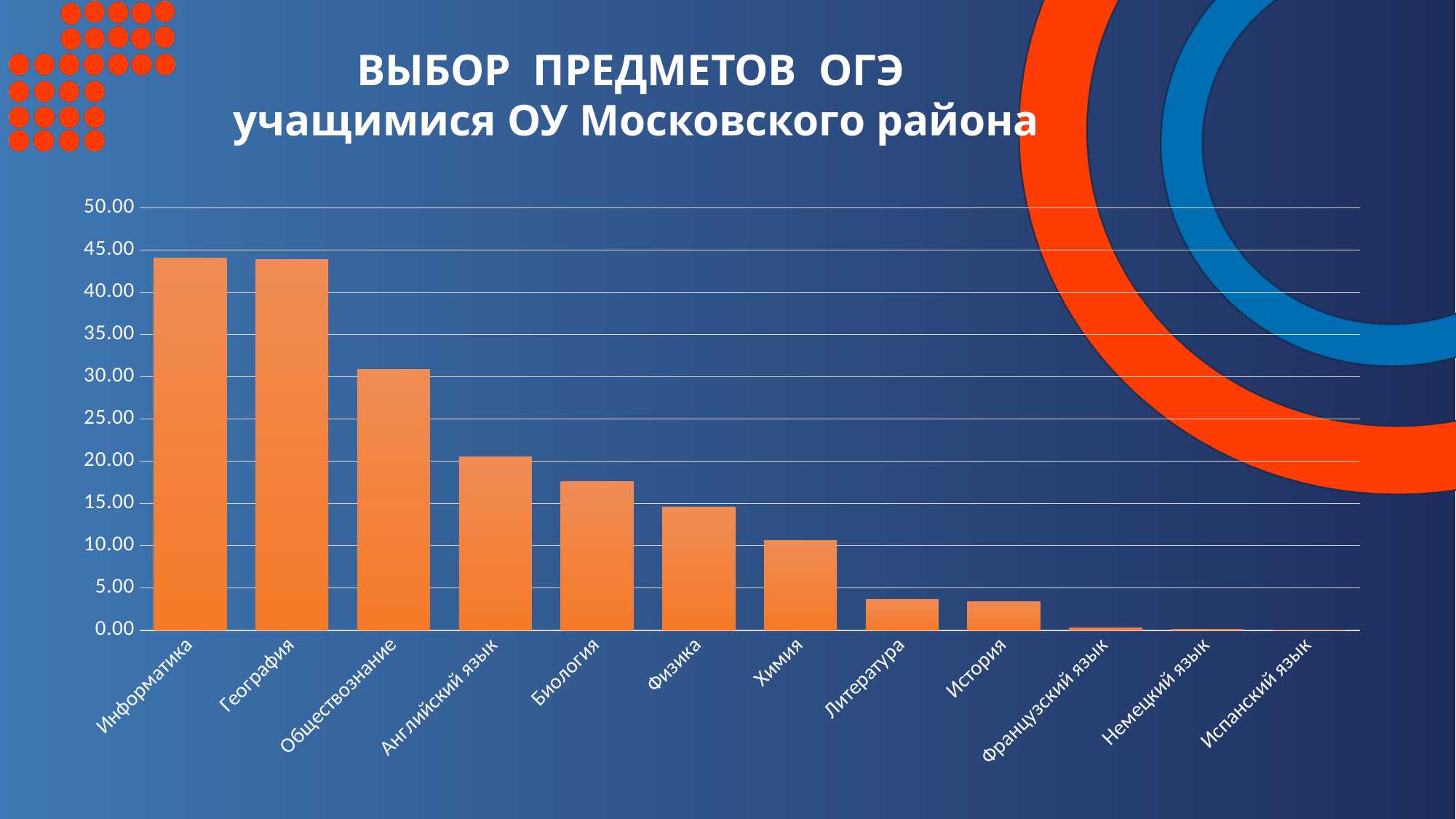
Is the value for Английский язык greater or less than 15.00? greater Is the value for Литература greater or less than 5.00? less What is the title of the chart on the slide? ВЫБОР ПРЕДМЕТОВ ОГЭ учащимися ОУ Московского района Which has the larger value, Обществознание or Английский язык? Обществознание Is the value for Биология greater or less than 20.00? less What kind of chart is shown on the slide? bar chart Do the bar values rise or fall from left to right along the x axis? fall Which has the larger value, Биология or Физика? Биология How many subjects (categories) are shown on the x axis of the chart? 12